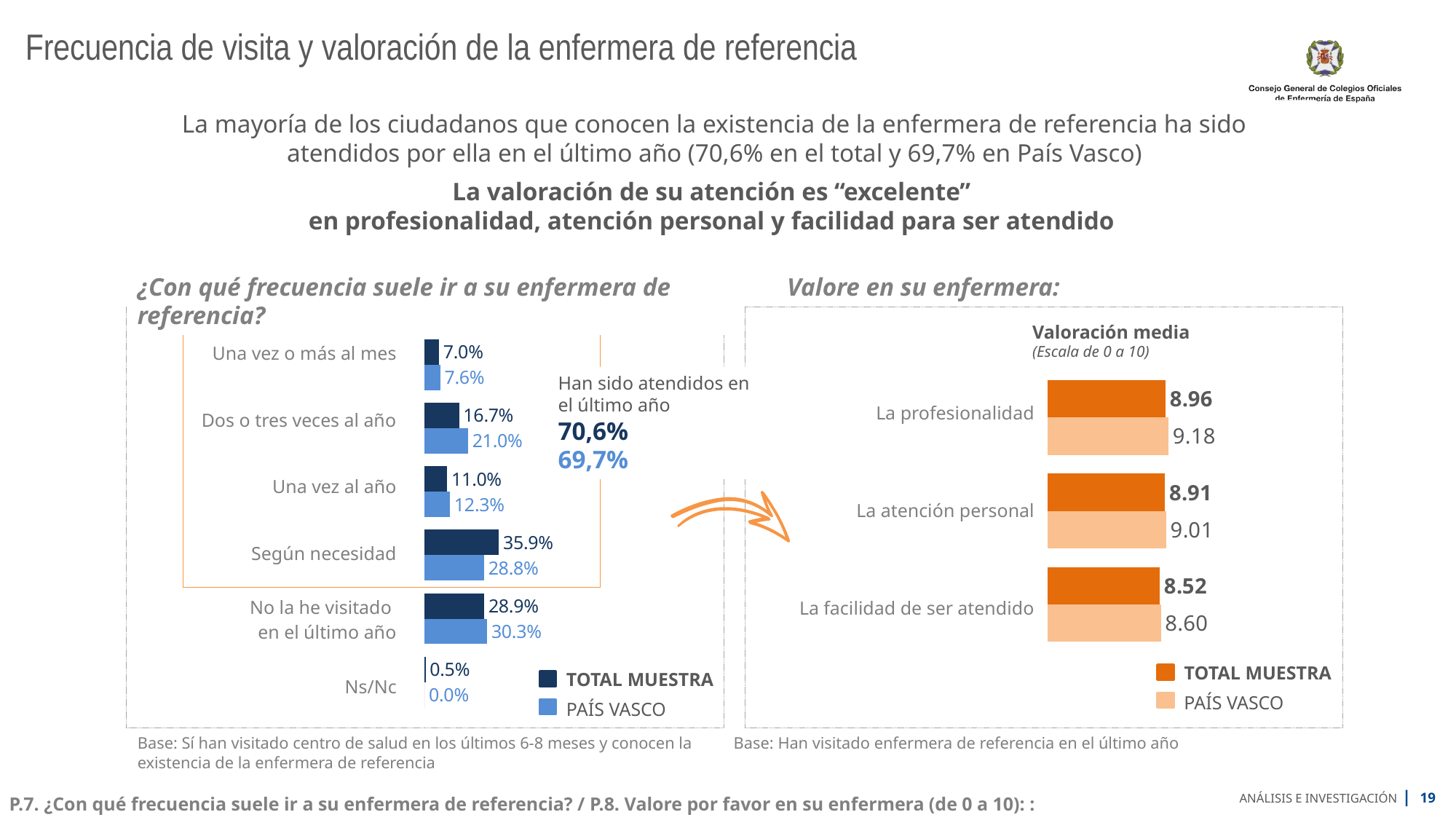
In the right chart (Valore en su enfermera), what is the PAÍS VASCO score for 'La profesionalidad'? 9.18 In the left chart (¿Con qué frecuencia suele ir a su enfermera de referencia?), which is larger for 'No la he visitado en el último año': TOTAL MUESTRA or PAÍS VASCO? PAÍS VASCO In the left chart (¿Con qué frecuencia suele ir a su enfermera de referencia?), which category has the highest TOTAL MUESTRA value? Según necesidad In the left chart (¿Con qué frecuencia suele ir a su enfermera de referencia?), what is the TOTAL MUESTRA value for 'Según necesidad'? 35.9% In the right chart (Valore en su enfermera), which attribute has the lowest TOTAL MUESTRA score? La facilidad de ser atendido In the left chart (¿Con qué frecuencia suele ir a su enfermera de referencia?), what is the PAÍS VASCO value for 'Dos o tres veces al año'? 21.0% In the right chart (Valore en su enfermera), what is the TOTAL MUESTRA score for 'La facilidad de ser atendido'? 8.52 How many categories are shown in the left chart (¿Con qué frecuencia suele ir a su enfermera de referencia?)? 6 In the left chart (¿Con qué frecuencia suele ir a su enfermera de referencia?), what is the difference between the TOTAL MUESTRA and PAÍS VASCO values for 'Según necesidad'? 7.1 percentage points What type of chart is the right chart (Valore en su enfermera)? Bar chart In the left chart (¿Con qué frecuencia suele ir a su enfermera de referencia?), which category has the lowest PAÍS VASCO value? Ns/Nc In the right chart (Valore en su enfermera), what is the difference between the PAÍS VASCO and TOTAL MUESTRA scores for 'La atención personal'? 0.10